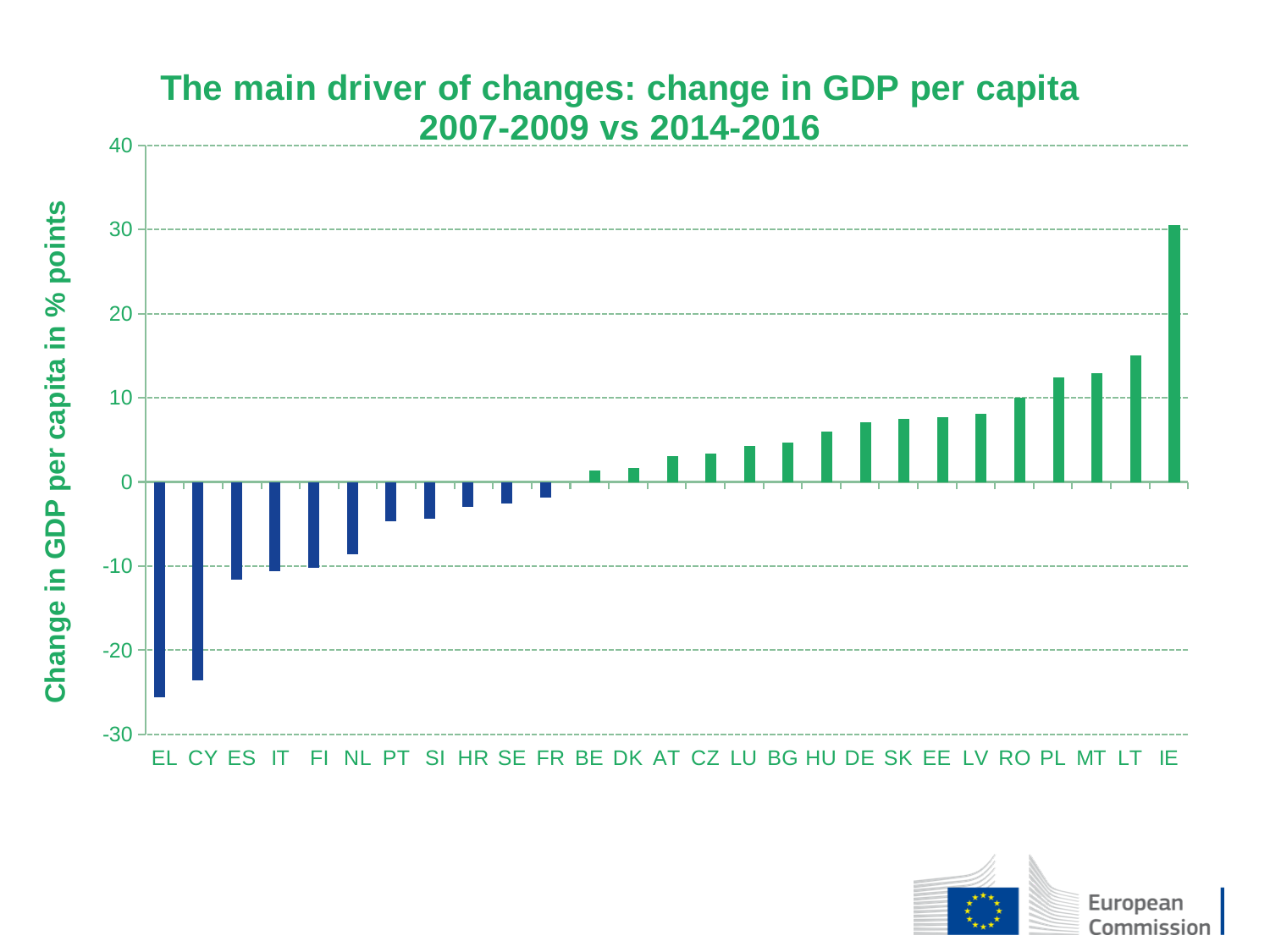
Do the values rise or fall moving from left to right along the x axis? rise What colour are the bars with negative values? blue How many countries are shown on the x axis? 27 Is the value for CY greater or less than -20? less Which country has the highest change in GDP per capita? IE Is the value for NL greater or less than -5? less Which has the larger value, IE or LT? IE Is the value for EL greater or less than -20? less What kind of chart is shown on the slide? bar chart Which country has the lowest change in GDP per capita? EL